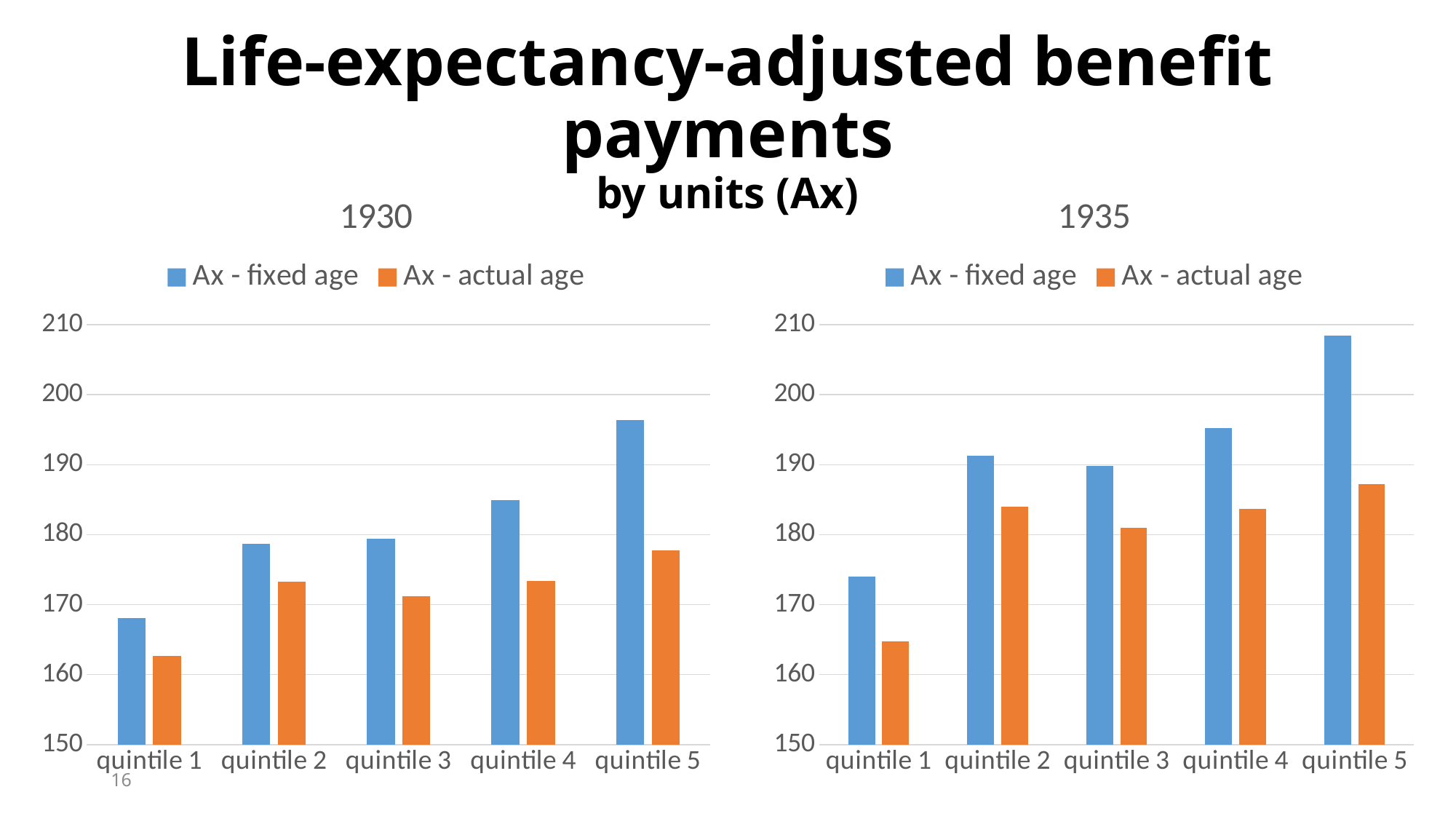
In the 1930 chart, which quintile has the lowest value for Ax - actual age? quintile 1 What type of chart is the 1935 chart? bar chart In the 1935 chart, which quintile has the highest value for Ax - fixed age? quintile 5 How many quintile categories are shown on the x axis of the 1935 chart? 5 In the 1930 chart, which has the larger Ax - fixed age value: quintile 2 or quintile 4? quintile 4 In the 1930 chart, is the Ax - actual age value for quintile 1 greater or less than 170? less In the 1930 chart, which quintile has the highest value for Ax - fixed age? quintile 5 In the 1930 chart, is the Ax - fixed age value for quintile 5 greater or less than 190? greater In the 1935 chart, which quintile has the lowest value for Ax - actual age? quintile 1 In the 1935 chart, is the Ax - fixed age value for quintile 5 greater or less than 200? greater In the 1935 chart, which is larger for quintile 1: Ax - fixed age or Ax - actual age? Ax - fixed age How many series does the legend of the 1930 chart list? 2